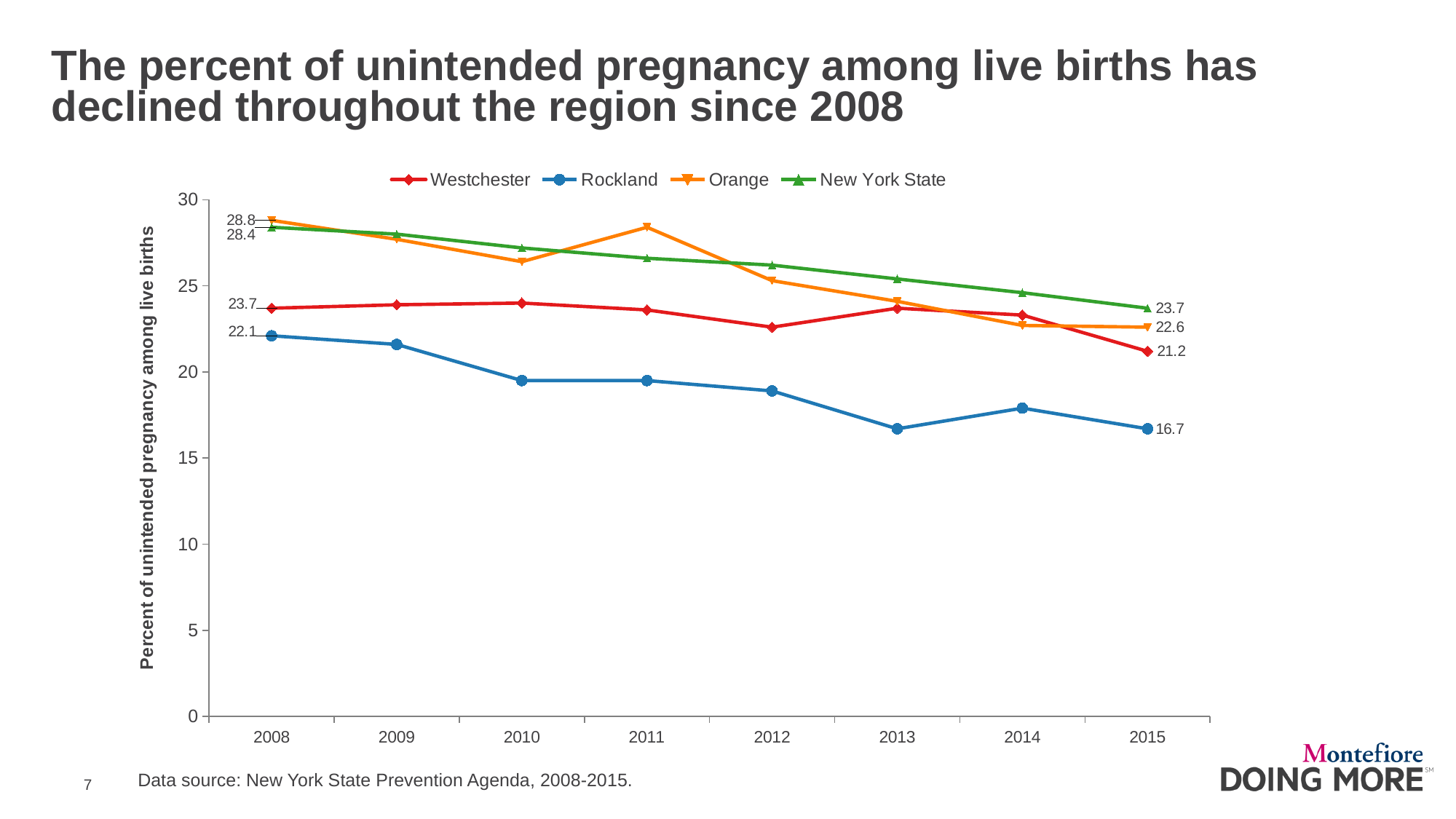
Which series had the lowest value in 2015? Rockland How many series does the legend list? 4 Which series had the highest value in 2008? Orange What type of chart is shown on the slide? Line chart Does the Rockland line generally rise or fall from 2008 to 2015? Fall By how much did the Westchester value change from 2008 (23.7) to 2015 (21.2)? 2.5 What was the value for Rockland in 2015? 16.7 What was the value for New York State in 2015? 23.7 How many years are shown on the x axis? 8 Is the value for Rockland in 2013 greater or less than 20? less What was the value for Westchester in 2008? 23.7 What was the value for Orange in 2008? 28.8